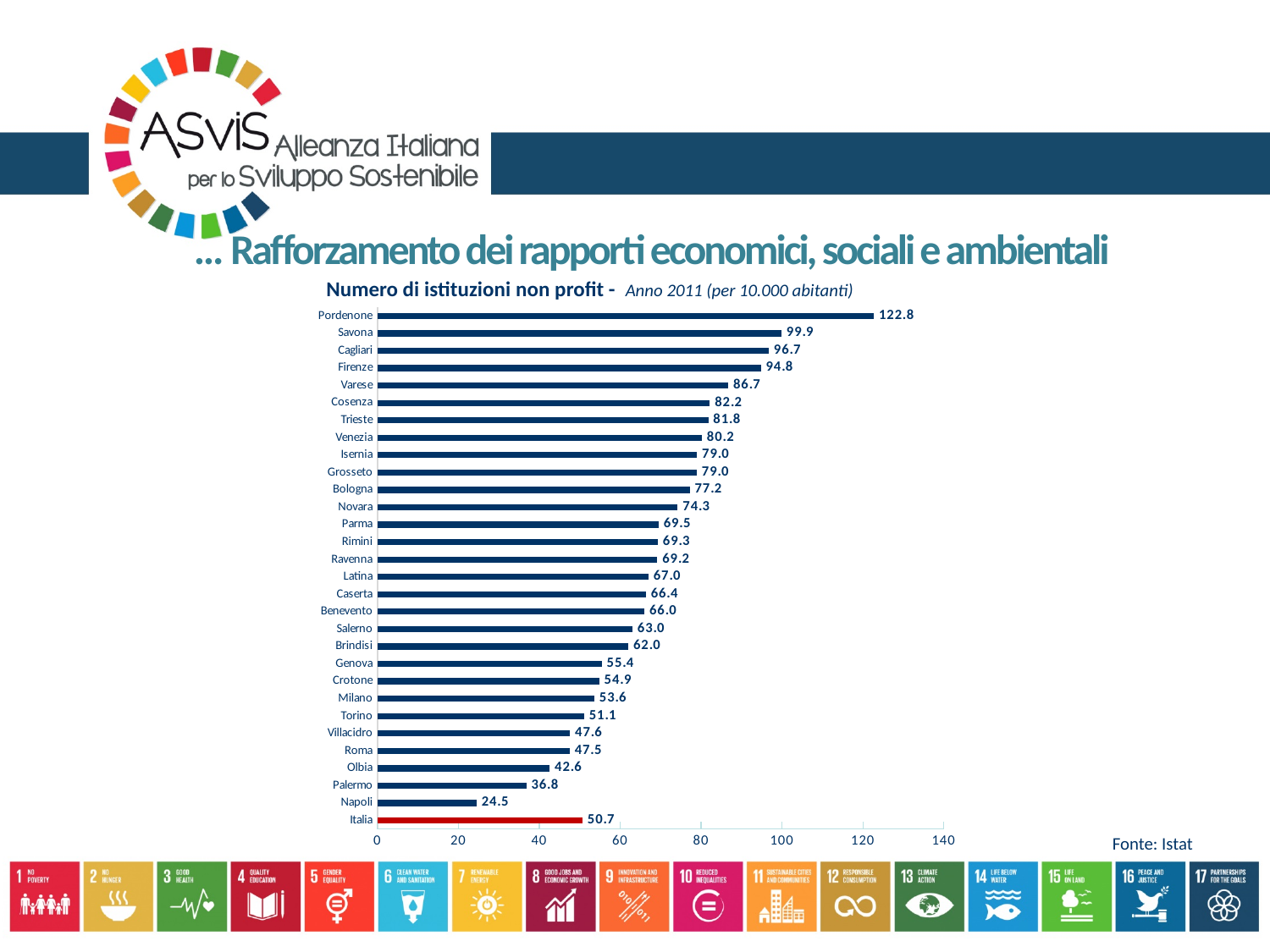
Is the value for Firenze greater or less than 100? less What is the title of the chart? Numero di istituzioni non profit - Anno 2011 (per 10.000 abitanti) Which category has the highest value? Pordenone What is the value for Italia? 50.7 Which has a larger value, Milano or Roma? Milano What is the difference between the values for Pordenone and Savona? 22.9 What is the value for Pordenone? 122.8 How many categories are shown in the chart? 30 Which category has the lowest value? Napoli What kind of chart is shown on the slide? Bar chart What is the difference between the values for Italia and Napoli? 26.2 What is the value for Napoli? 24.5